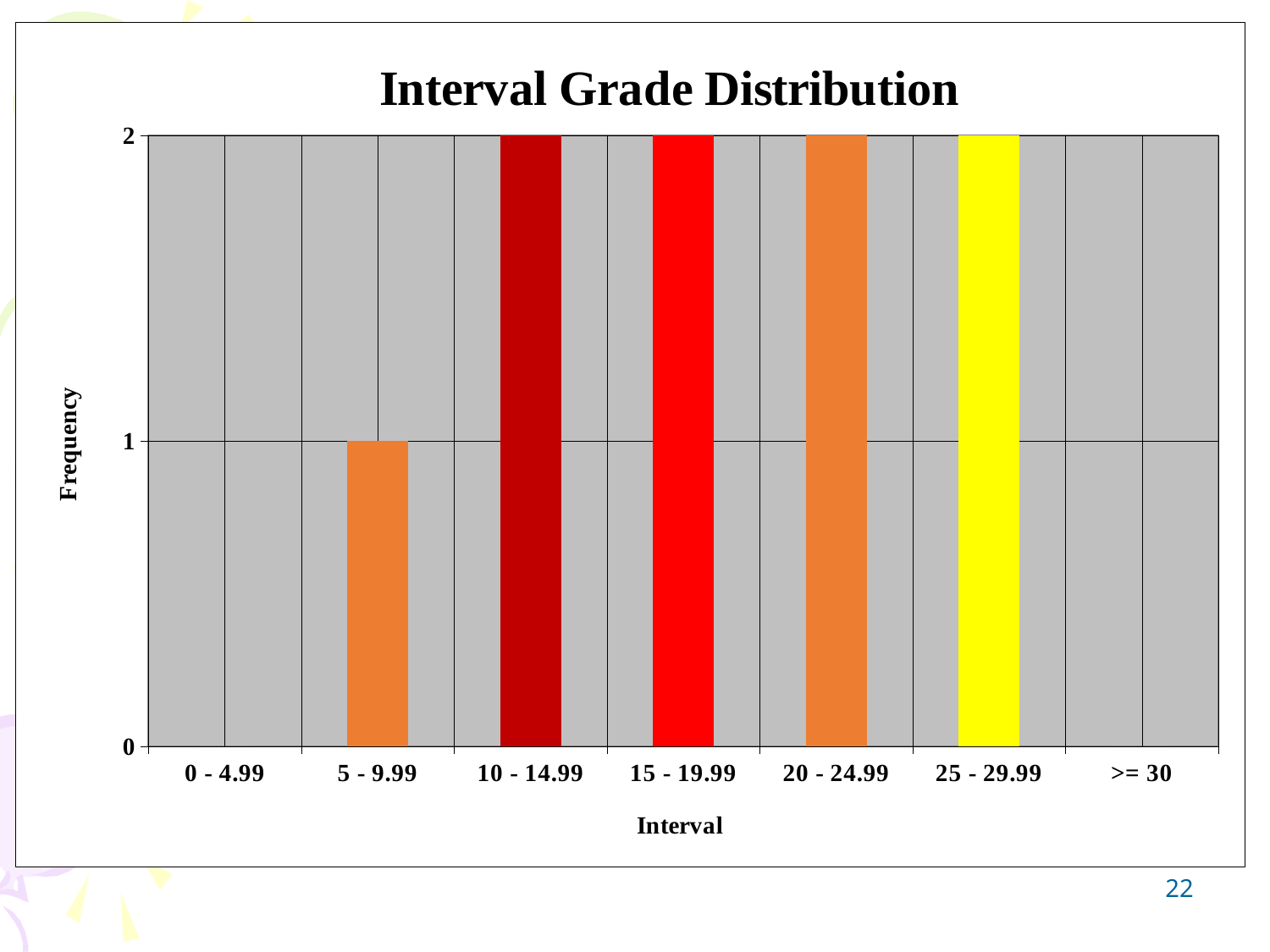
Which has the higher frequency, the 20 - 24.99 interval or the 5 - 9.99 interval? 20 - 24.99 What is the frequency for the 0 - 4.99 interval? 0 What is the difference in frequency between the 15 - 19.99 interval and the 5 - 9.99 interval? 1 Which interval has a frequency of exactly 1? 5 - 9.99 What is the frequency for the 25 - 29.99 interval? 2 What kind of chart is shown on the slide? Bar chart What is the frequency for the 5 - 9.99 interval? 1 What is the frequency for the 10 - 14.99 interval? 2 How many intervals are shown on the x axis? 7 What is the label of the vertical axis? Frequency What is the title of the chart? Interval Grade Distribution What is the frequency for the >= 30 interval? 0